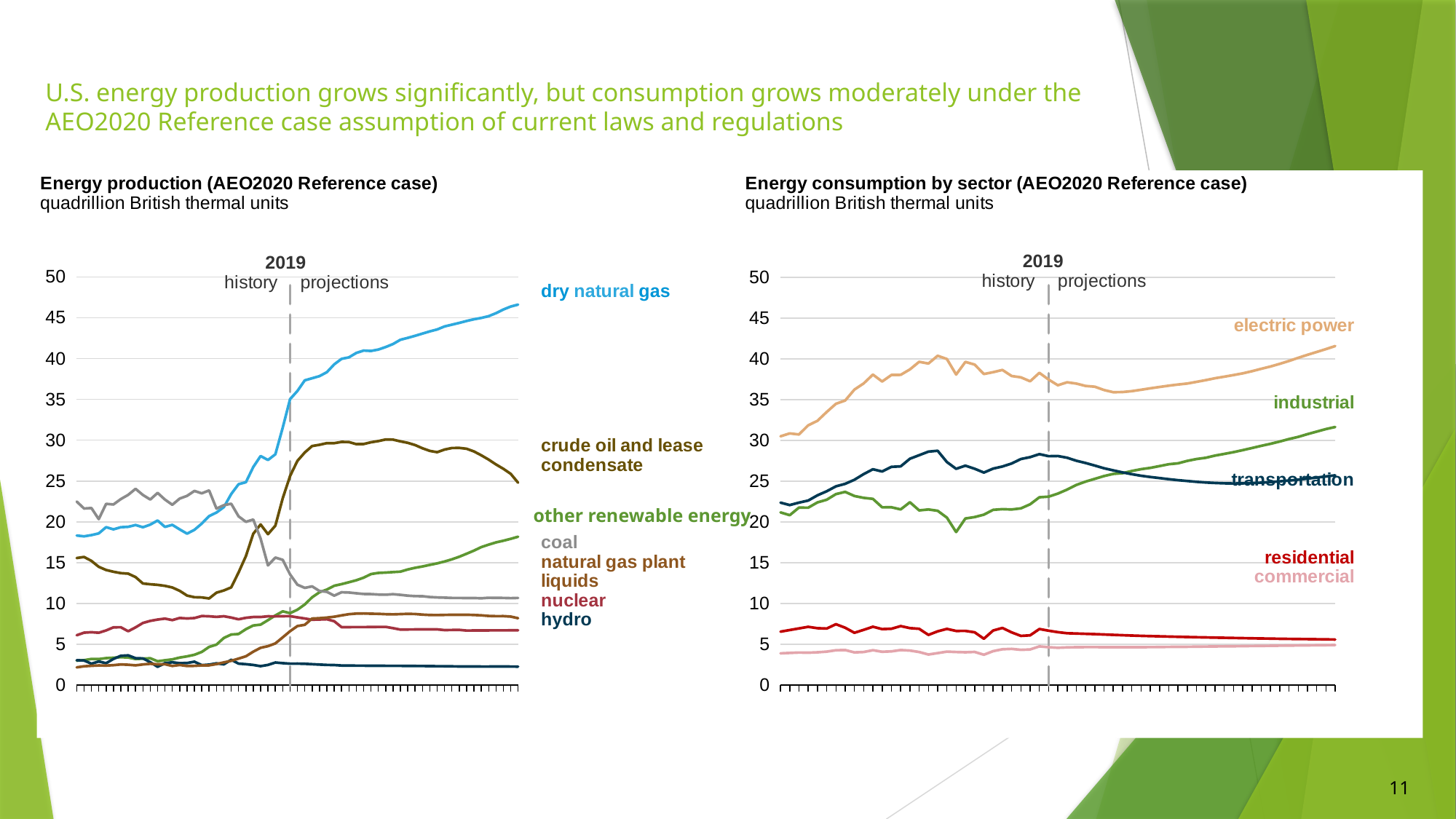
In the 'Energy consumption by sector' chart, at the end of the projection period, which is larger: industrial or transportation? industrial How many series are labelled on the 'Energy consumption by sector (AEO2020 Reference case)' chart? 5 In the 'Energy production' chart, which series has the lowest value at the end of the projection period? hydro How many series are labelled on the 'Energy production (AEO2020 Reference case)' chart? 7 In the 'Energy production' chart, is the value for dry natural gas at the end of the projections greater or less than 45? greater In the 'Energy consumption by sector' chart, which sector has the highest value at the end of the projection period? electric power In the 'Energy consumption by sector' chart, is the value for commercial at the end of the projections greater or less than 10? less What year does the dashed vertical line separating history from projections mark on both charts? 2019 In the 'Energy consumption by sector' chart, does the transportation line rise or fall over the projection period? fall In the 'Energy production' chart, which series has the highest value at the end of the projection period? dry natural gas What kind of chart is the 'Energy production (AEO2020 Reference case)' chart? line chart In the 'Energy consumption by sector' chart, is the value for electric power at the end of the projections greater or less than 40? greater